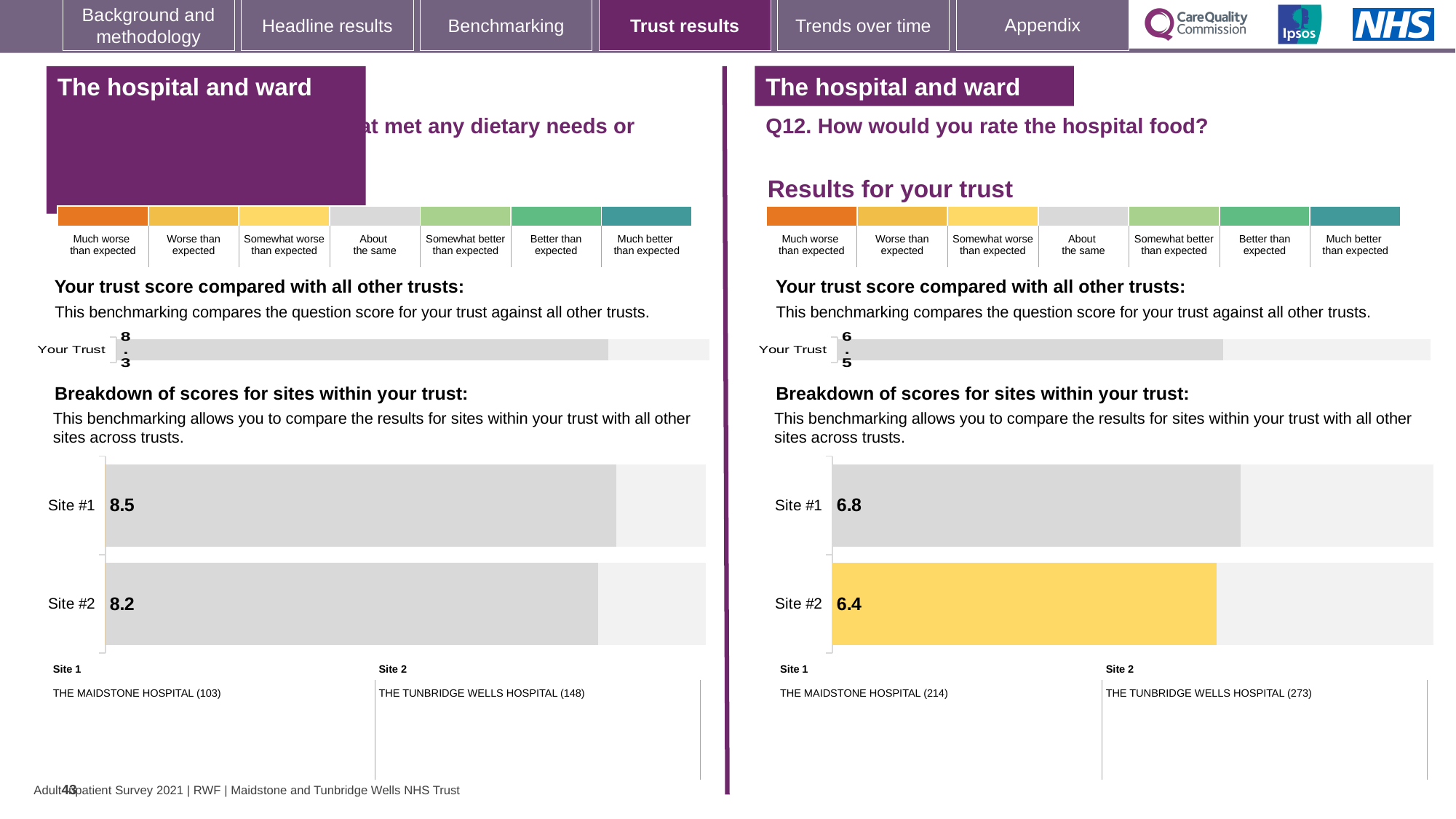
On the right-hand side of the slide (Q12), what is the difference between the Site #1 and Site #2 scores? 0.4 On the left-hand side of the slide, what is the score for Site #1 in the breakdown of scores for sites within your trust? 8.5 What type of chart is used for the breakdown of scores for sites within your trust on the right-hand side of the slide (Q12)? Bar chart On the right-hand side of the slide (Q12), which site has the higher score in the breakdown of scores for sites within your trust? Site #1 On the left-hand side of the slide, what is the difference between the Site #1 and Site #2 scores? 0.3 On the right-hand side of the slide (Q12. How would you rate the hospital food?), what is the score for Site #1 in the breakdown of scores for sites within your trust? 6.8 On the left-hand side of the slide, what is the score shown for Your Trust in the trust score comparison chart? 8.3 On the left-hand side of the slide, which site has the lower score in the breakdown of scores for sites within your trust? Site #2 How many sites are shown in the breakdown of scores chart on the right-hand side of the slide (Q12)? 2 On the right-hand side of the slide (Q12. How would you rate the hospital food?), what is the score shown for Your Trust in the trust score comparison chart? 6.5 On the left-hand side of the slide, what is the score for Site #2 in the breakdown of scores for sites within your trust? 8.2 On the right-hand side of the slide (Q12. How would you rate the hospital food?), what is the score for Site #2 in the breakdown of scores for sites within your trust? 6.4